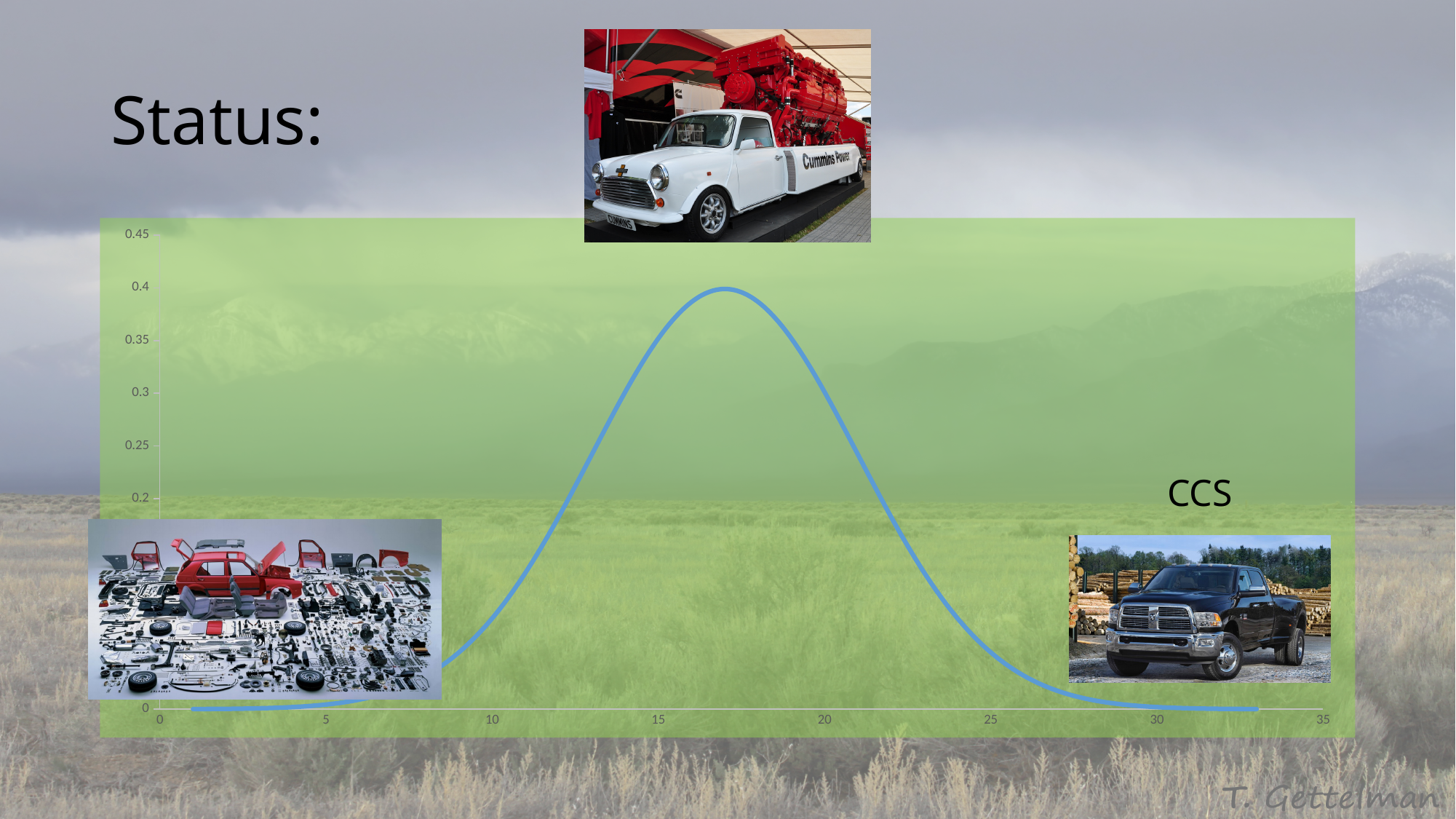
Is the peak value of the curve greater or less than 0.45? less What kind of chart is shown on the slide? line chart Is the value of the curve at x = 10 greater or less than 0.2? less Is the value of the curve at x = 15 larger or smaller than the value at x = 25? larger Is the value of the curve at x = 25 greater or less than 0.2? less How does the curve behave as x increases from 0 to 35? rises to a peak then falls What is the highest value labelled on the y axis? 0.45 What is the highest value labelled on the x axis? 35